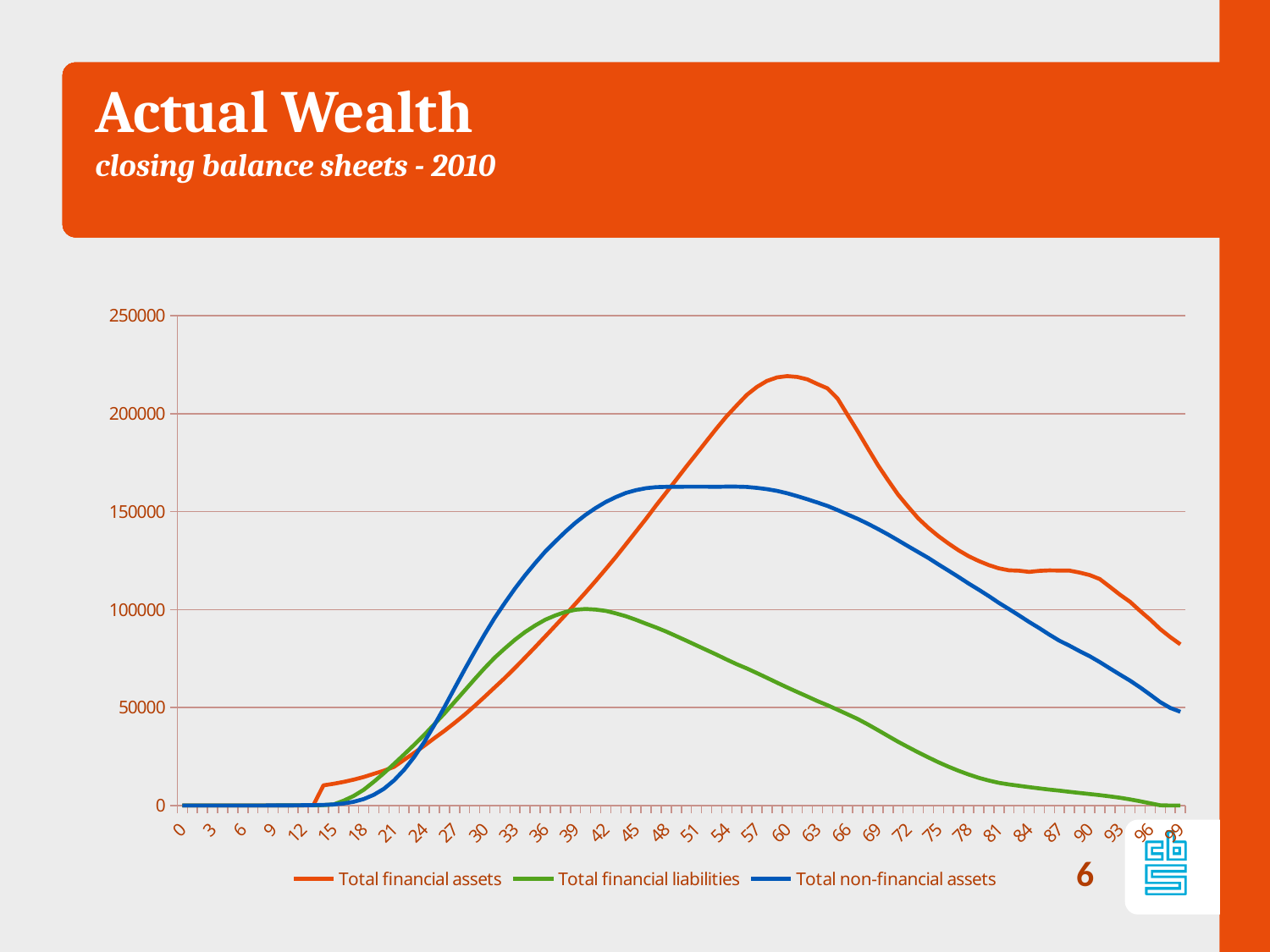
Does Total non-financial assets rise or fall along the x axis from 18 to 48? rise Is the value for Total financial assets at 99 greater or less than 100000? less Is the value for Total financial assets at 60 greater or less than 200000? greater Which series reaches the highest peak value on the chart? Total financial assets Is the value for Total non-financial assets at 48 greater or less than 150000? greater Does Total financial liabilities rise or fall along the x axis from 39 to 99? fall At 30, which is larger: Total financial liabilities or Total financial assets? Total financial liabilities What are the three series named in the legend? Total financial assets, Total financial liabilities, Total non-financial assets What kind of chart is shown on the slide? line chart At 60, which is larger: Total financial assets or Total non-financial assets? Total financial assets How many series does the legend list? 3